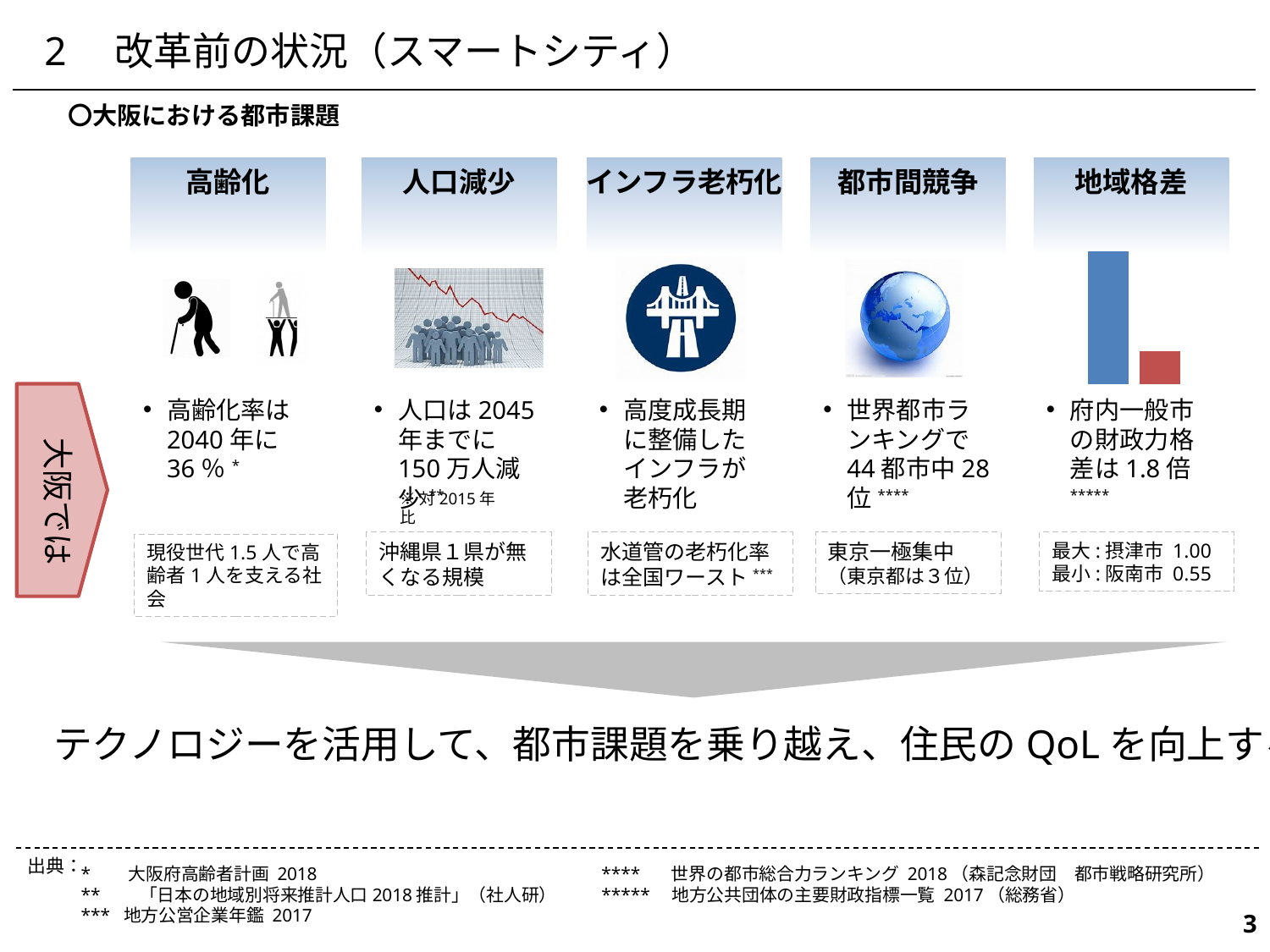
In the chart under the 地域格差 heading, which bar is taller, the blue one or the red one? the blue one How many bars does the chart under the 地域格差 heading show? 2 In the chart under the 地域格差 heading, what colour is the shorter bar? red Under which of the five urban-issue headings is the bar chart placed? 地域格差 What kind of chart appears under the 地域格差 heading? bar chart